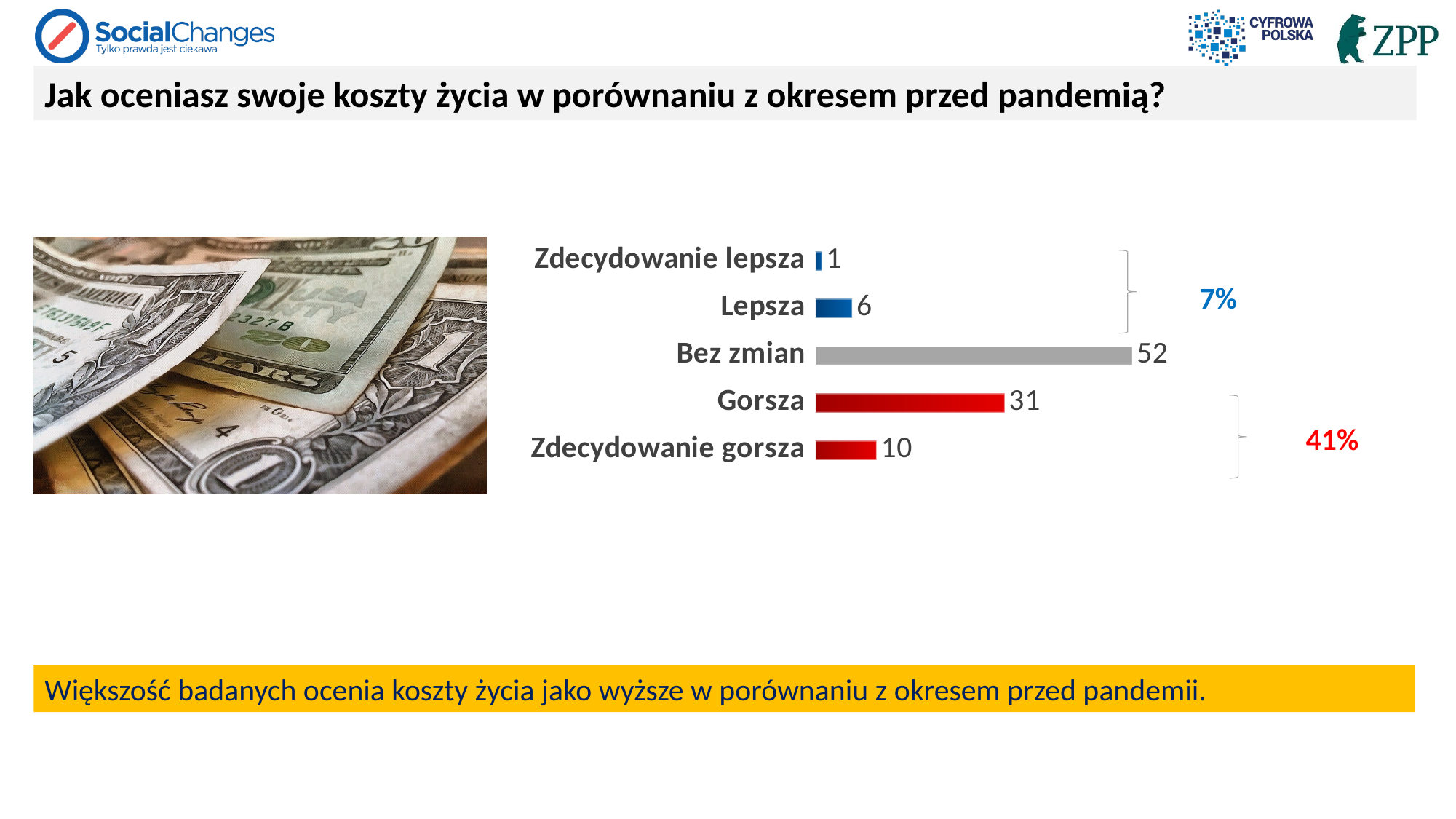
What is the value for "Bez zmian"? 52 What kind of chart is shown on the slide? Bar chart Which category has the lowest value? Zdecydowanie lepsza What is the value for "Gorsza"? 31 Which is larger, the value for "Gorsza" or the value for "Zdecydowanie gorsza"? Gorsza What is the difference between the values for "Bez zmian" and "Gorsza"? 21 What is the value for "Zdecydowanie gorsza"? 10 How many categories are shown in the chart? 5 What is the value for "Zdecydowanie lepsza"? 1 Which category has the highest value? Bez zmian What is the value for "Lepsza"? 6 What combined percentage is shown next to the bracket grouping "Gorsza" and "Zdecydowanie gorsza"? 41%